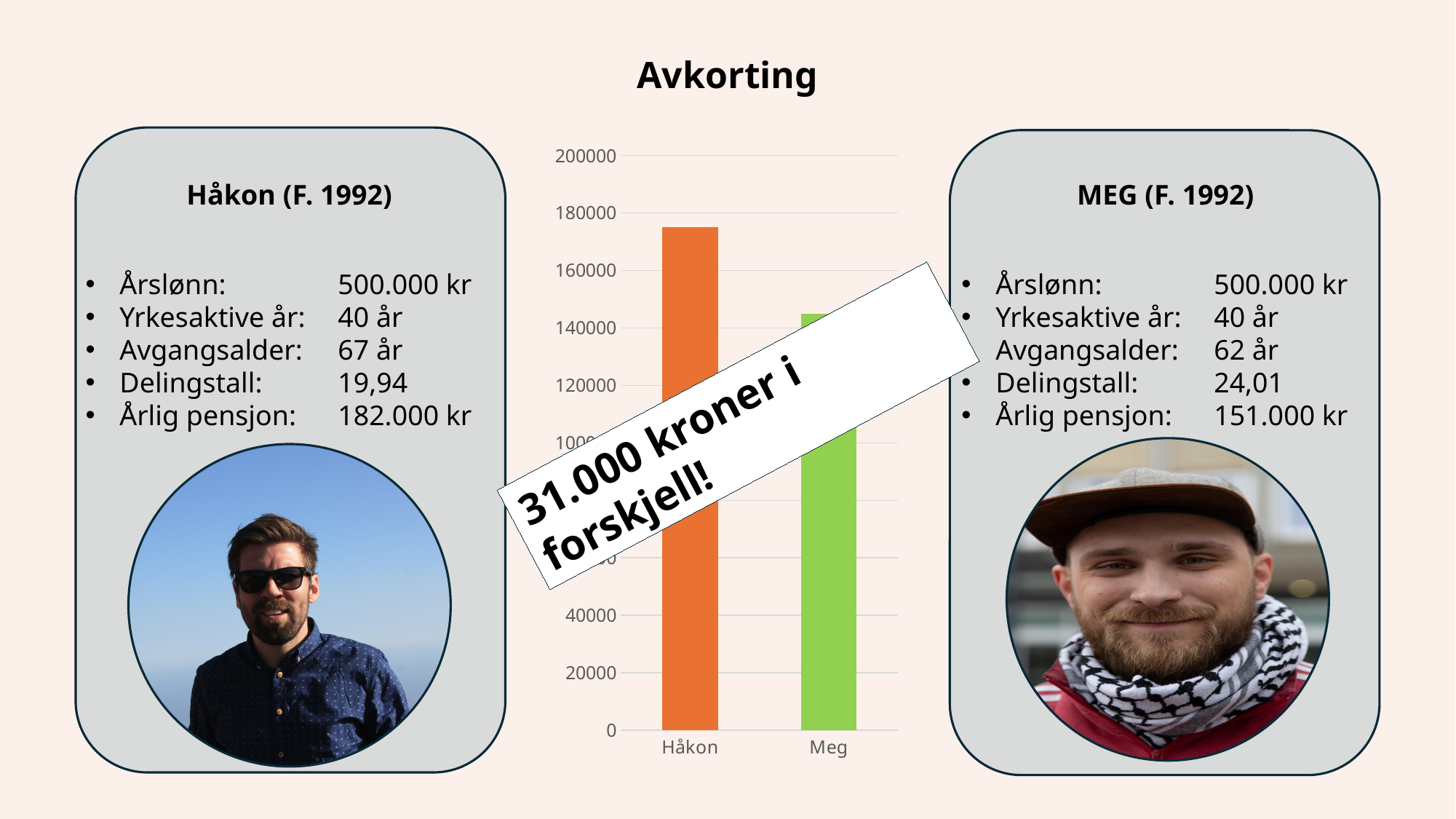
What colour is the bar for Håkon? orange Which bar is taller, Håkon or Meg? Håkon Which category has the lowest bar in the chart? Meg Which category has the highest bar in the chart? Håkon Is the value for Meg greater or less than 160000? less How many bars does the chart show? 2 Is the value for Meg greater or less than 120000? greater What is the highest value shown on the vertical axis of the chart? 200000 Is the value for Håkon greater or less than 160000? greater What kind of chart is shown on the slide? bar chart